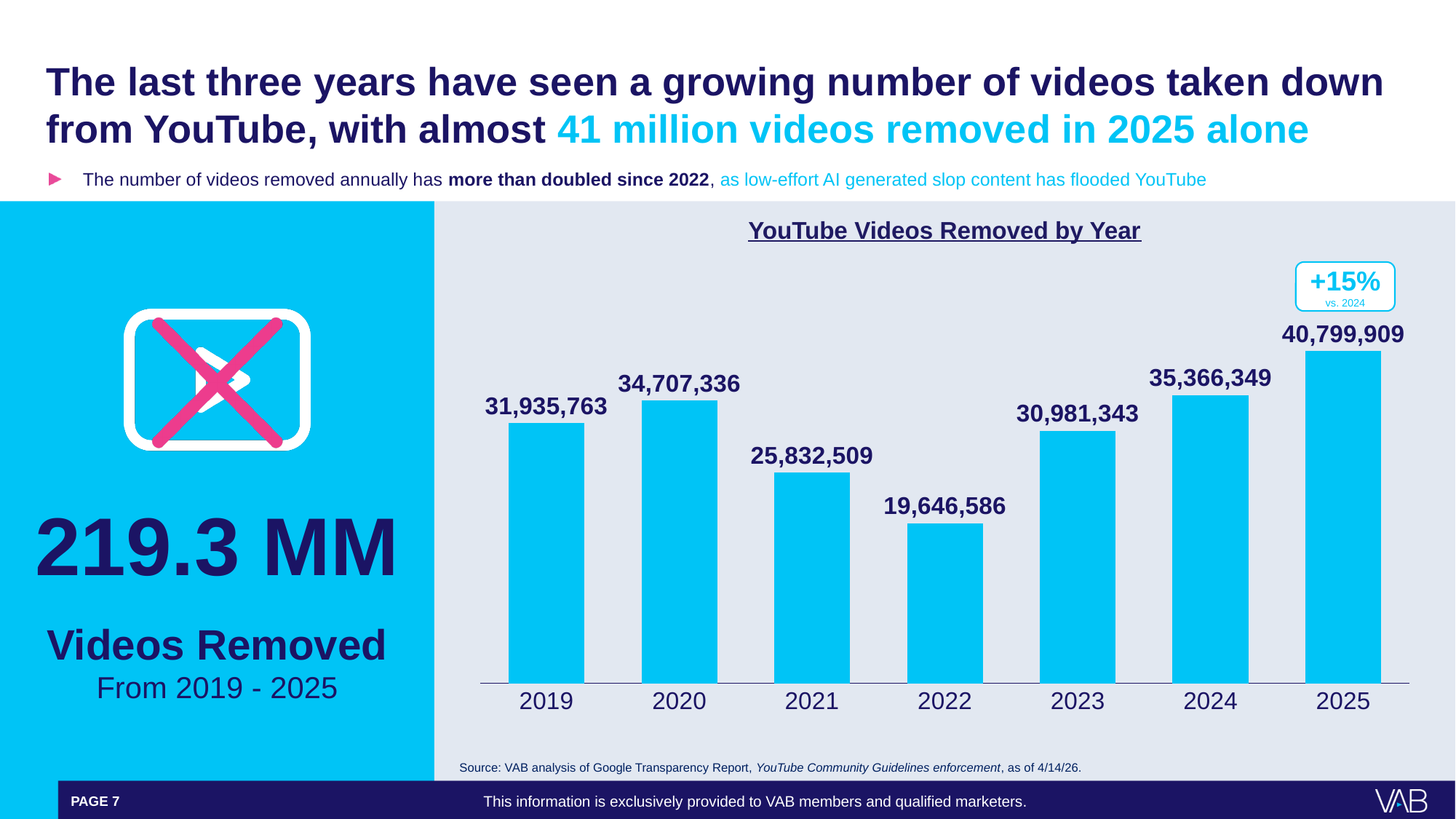
What is the difference between the number of videos removed in 2021 and in 2022? 6,185,923 Which year had the highest number of videos removed? 2025 What type of chart is shown on the slide? Bar chart What is the title of the chart? YouTube Videos Removed by Year What is the difference between the number of videos removed in 2025 and in 2024? 5,433,560 How many years are shown on the x axis of the chart? 7 How many YouTube videos were removed in 2020? 34,707,336 How many YouTube videos were removed in 2025? 40,799,909 Which year had the lowest number of videos removed? 2022 Which year had more videos removed, 2019 or 2023? 2019 How many YouTube videos were removed in 2022? 19,646,586 Do the values rise or fall from 2022 to 2025? Rise